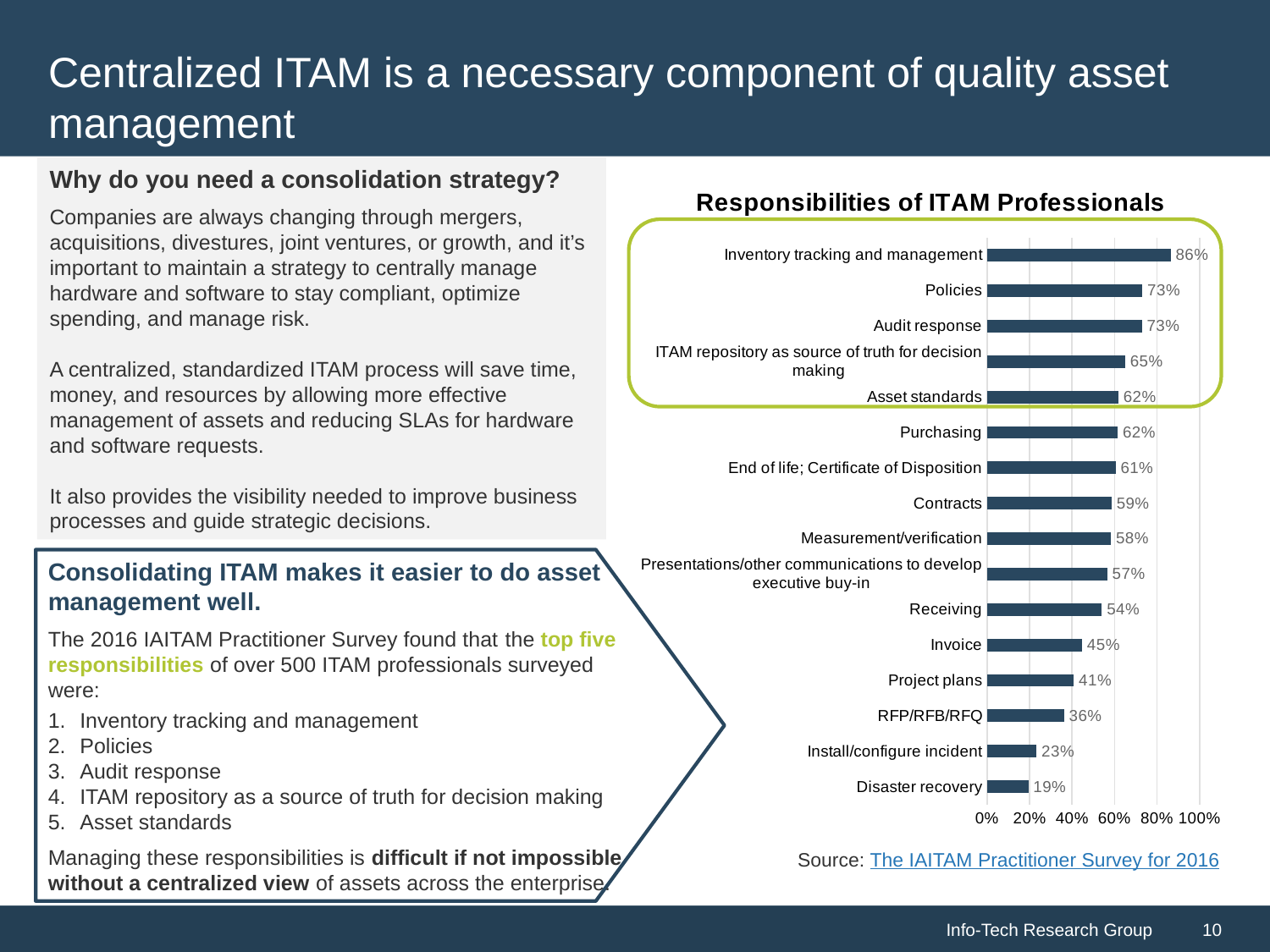
What is the value for Disaster recovery? 19% How many responsibilities are shown in the chart? 16 What is the difference between the values for Inventory tracking and management and Policies? 13% What is the value for Receiving? 54% Which responsibility has the highest value? Inventory tracking and management What is the value for Inventory tracking and management? 86% Which is larger, the value for Invoice or the value for Project plans? Invoice Is the value for RFP/RFB/RFQ greater or less than 40%? less What kind of chart is shown on the slide? Bar chart Which responsibility has the lowest value? Disaster recovery What is the title of the chart? Responsibilities of ITAM Professionals What is the difference between the values for Install/configure incident and Disaster recovery? 4%